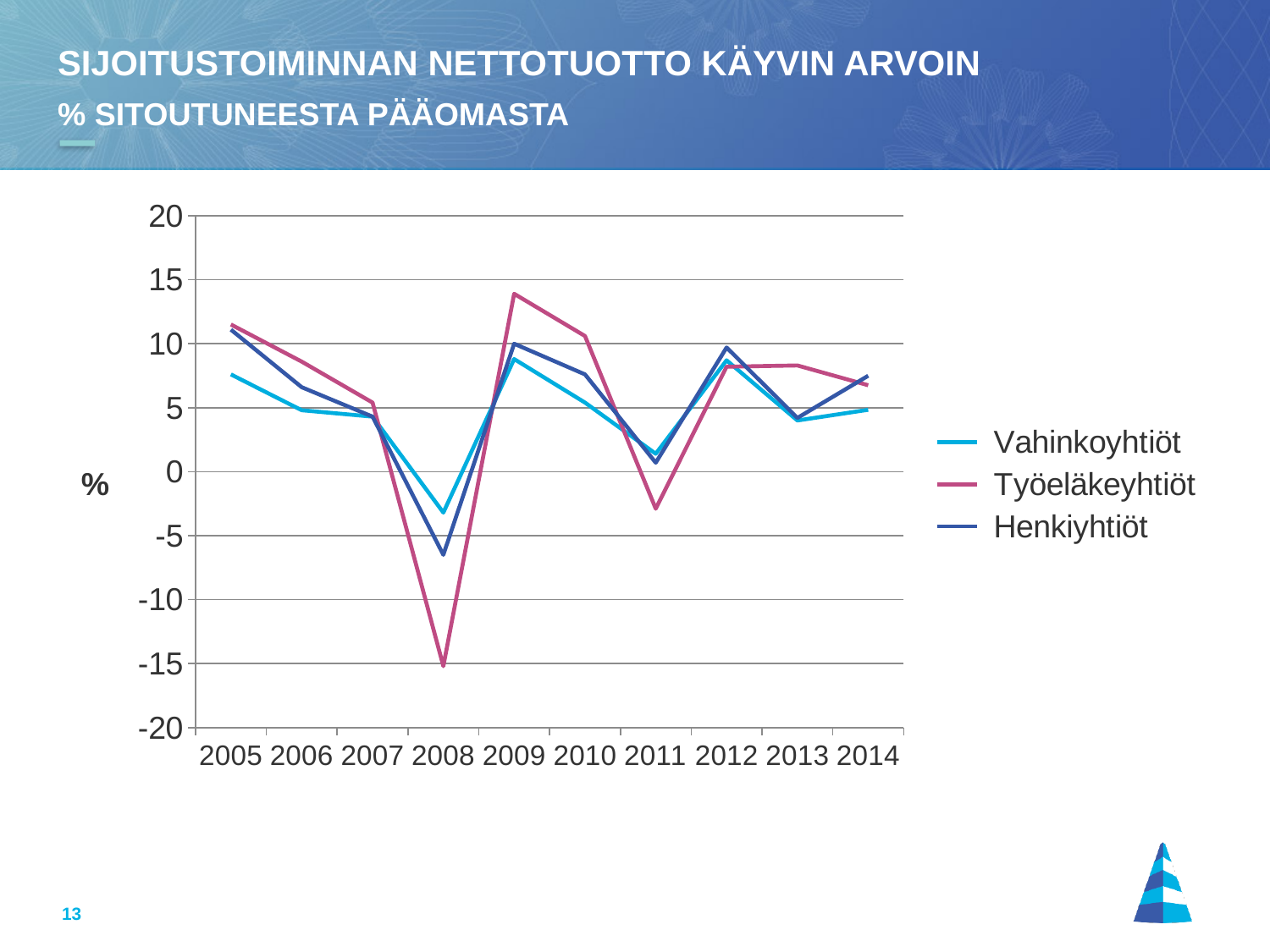
How many years are shown on the x axis? 10 In 2008, which is larger: the value for Vahinkoyhtiöt or the value for Työeläkeyhtiöt? Vahinkoyhtiöt Is the value for Työeläkeyhtiöt in 2008 greater or less than -10? less Do the values for Työeläkeyhtiöt rise or fall from 2007 to 2008? fall What kind of chart is shown on the slide? line chart Is the value for Työeläkeyhtiöt in 2009 greater or less than 10? greater Which series is shown in magenta in the legend? Työeläkeyhtiöt In which year is the value for Työeläkeyhtiöt lowest? 2008 In which year is the value for Henkiyhtiöt lowest? 2008 What is the label on the vertical axis? % How many series does the legend list? 3 In which year is the value for Työeläkeyhtiöt highest? 2009